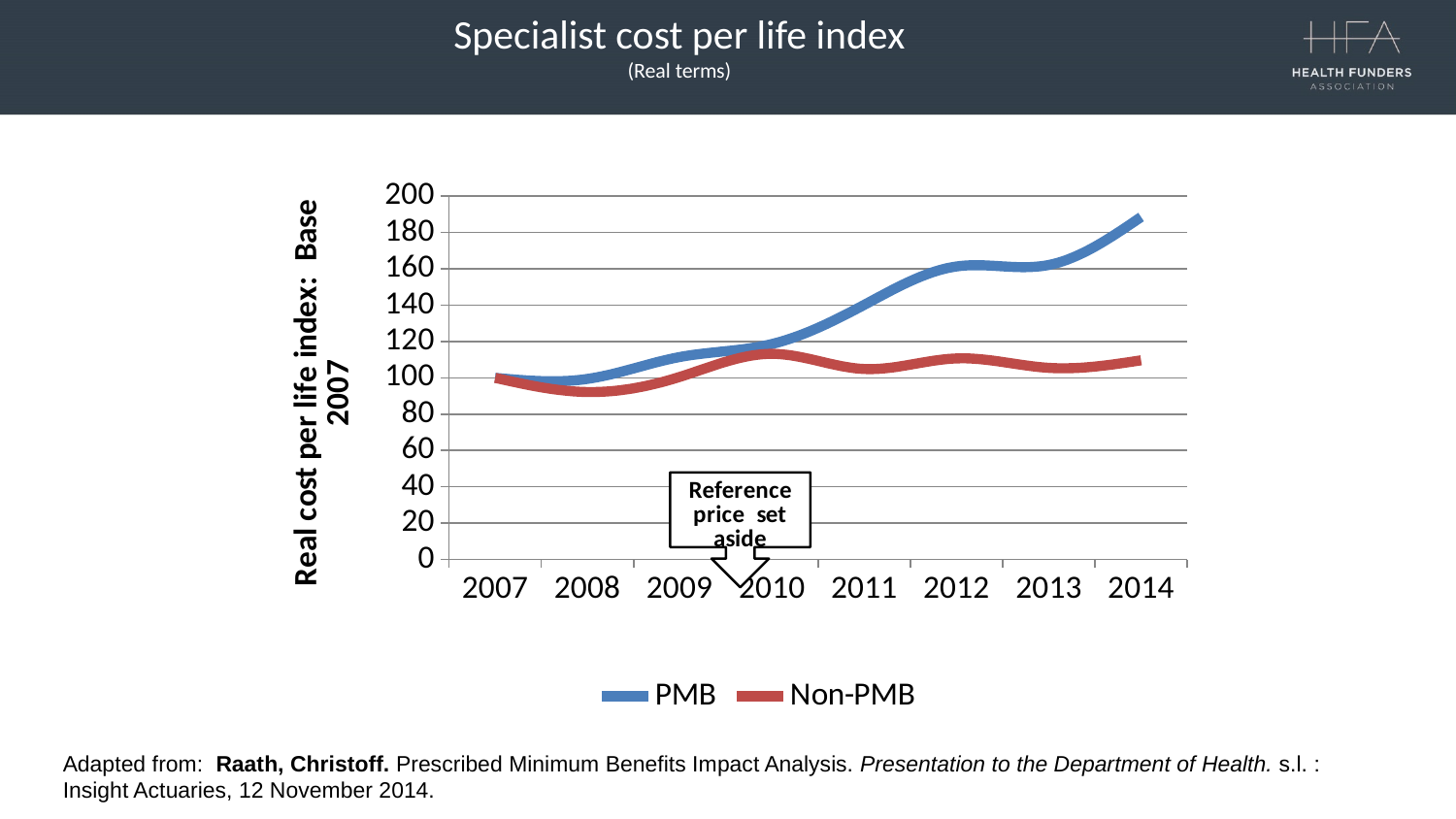
In which year is the PMB series at its highest? 2014 Is the PMB value for 2014 greater or less than 180? greater What kind of chart is shown on the slide? line chart How many years are shown on the x axis? 8 Is the PMB value for 2011 greater or less than 120? greater How many series does the legend list? 2 Does the PMB series generally rise or fall from 2007 to 2014? rise Which series is higher in 2011, PMB or Non-PMB? PMB Which year does the 'Reference price set aside' annotation point to? 2010 Which series is higher in 2014, PMB or Non-PMB? PMB In which year is the Non-PMB series at its lowest? 2008 Is the Non-PMB value for 2014 greater or less than 120? less